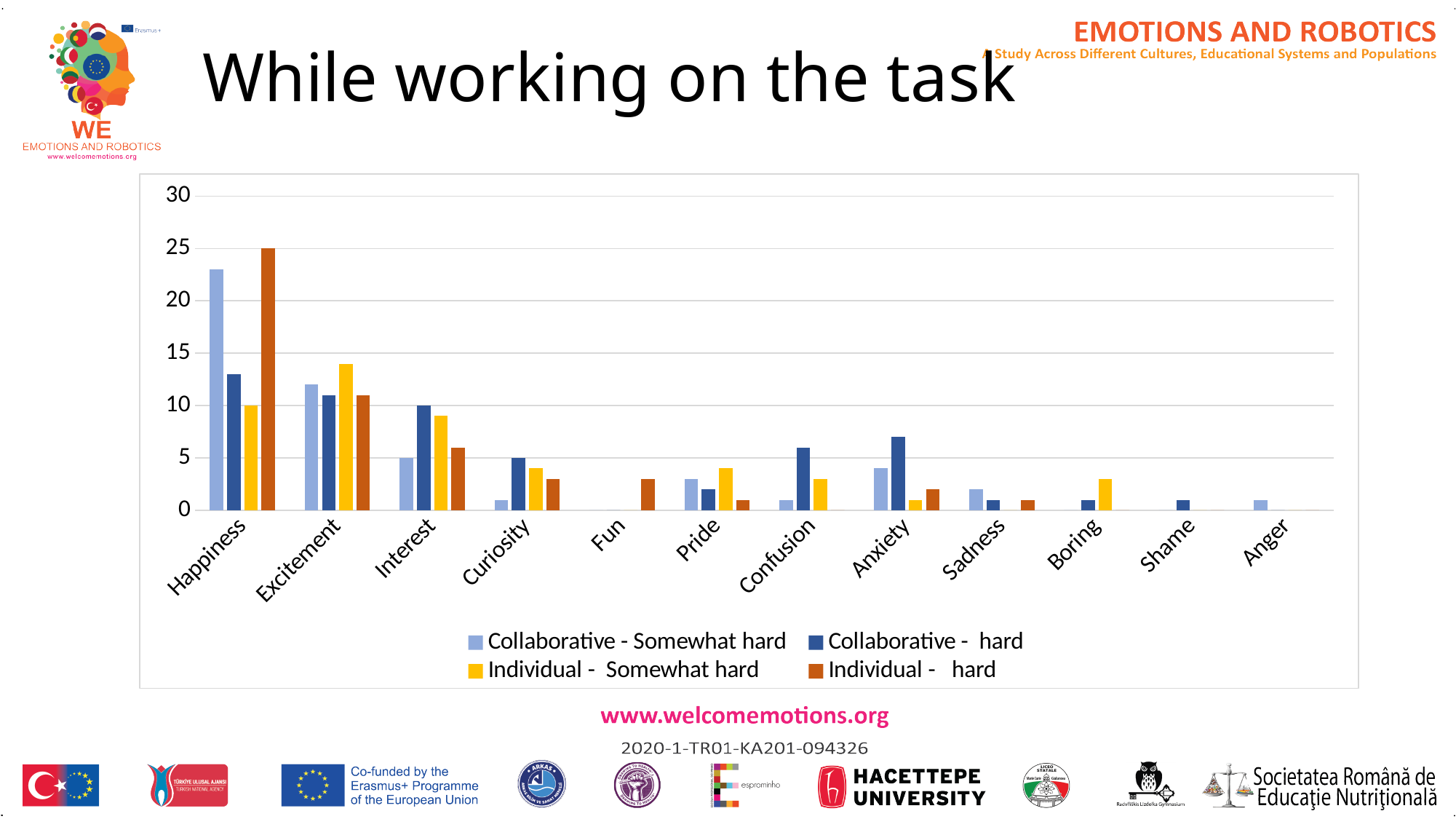
Which category has the highest value for Individual - hard? Happiness What is the value of Individual - Somewhat hard for Happiness? 10 How many emotion categories are shown on the x axis? 12 For Happiness, which is larger: Collaborative - Somewhat hard or Collaborative - hard? Collaborative - Somewhat hard Which category has the highest value for Collaborative - Somewhat hard? Happiness How many series does the legend list? 4 Which series is shown in yellow in the legend? Individual - Somewhat hard What is the value of Collaborative - hard for Interest? 10 What is the value of Collaborative - hard for Curiosity? 5 Is the value of Collaborative - Somewhat hard for Happiness greater or less than 20? greater What kind of chart is shown on the slide? bar chart What is the value of Individual - hard for Happiness? 25